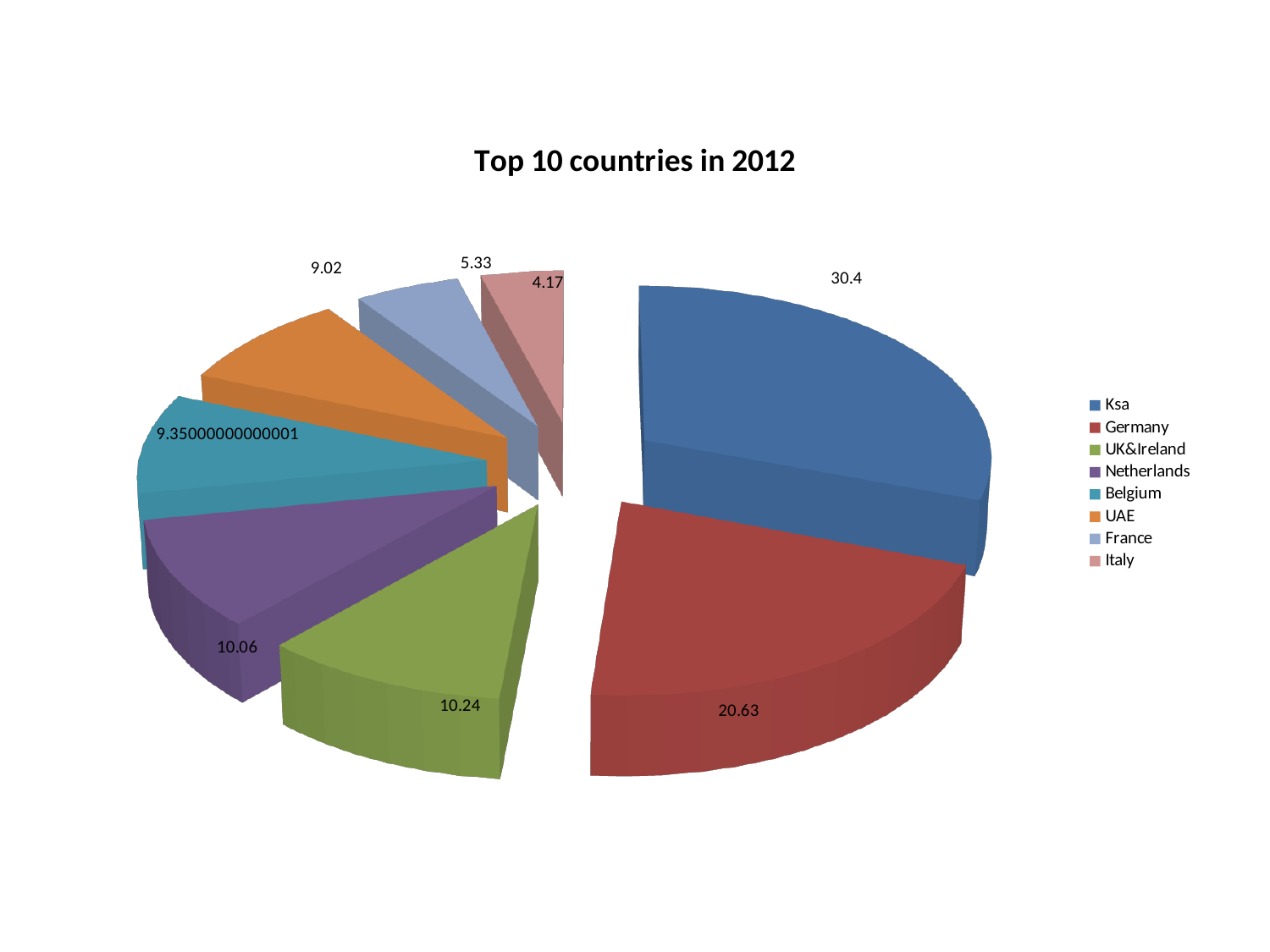
What is the difference between the values for Ksa and Germany? 9.77 What is the difference between the values for France and Italy? 1.16 What is the value shown for Germany? 20.63 Which country has the largest slice of the pie? Ksa What is the value shown for Ksa? 30.4 What value is labelled on the Belgium slice? 9.35000000000001 Which is larger, the value for UK&Ireland or the value for UAE? UK&Ireland What is the value shown for France? 5.33 How many slices does the pie chart have? 8 What kind of chart is shown on the slide? Pie chart What is the title of the chart? Top 10 countries in 2012 Which country has the smallest slice of the pie? Italy